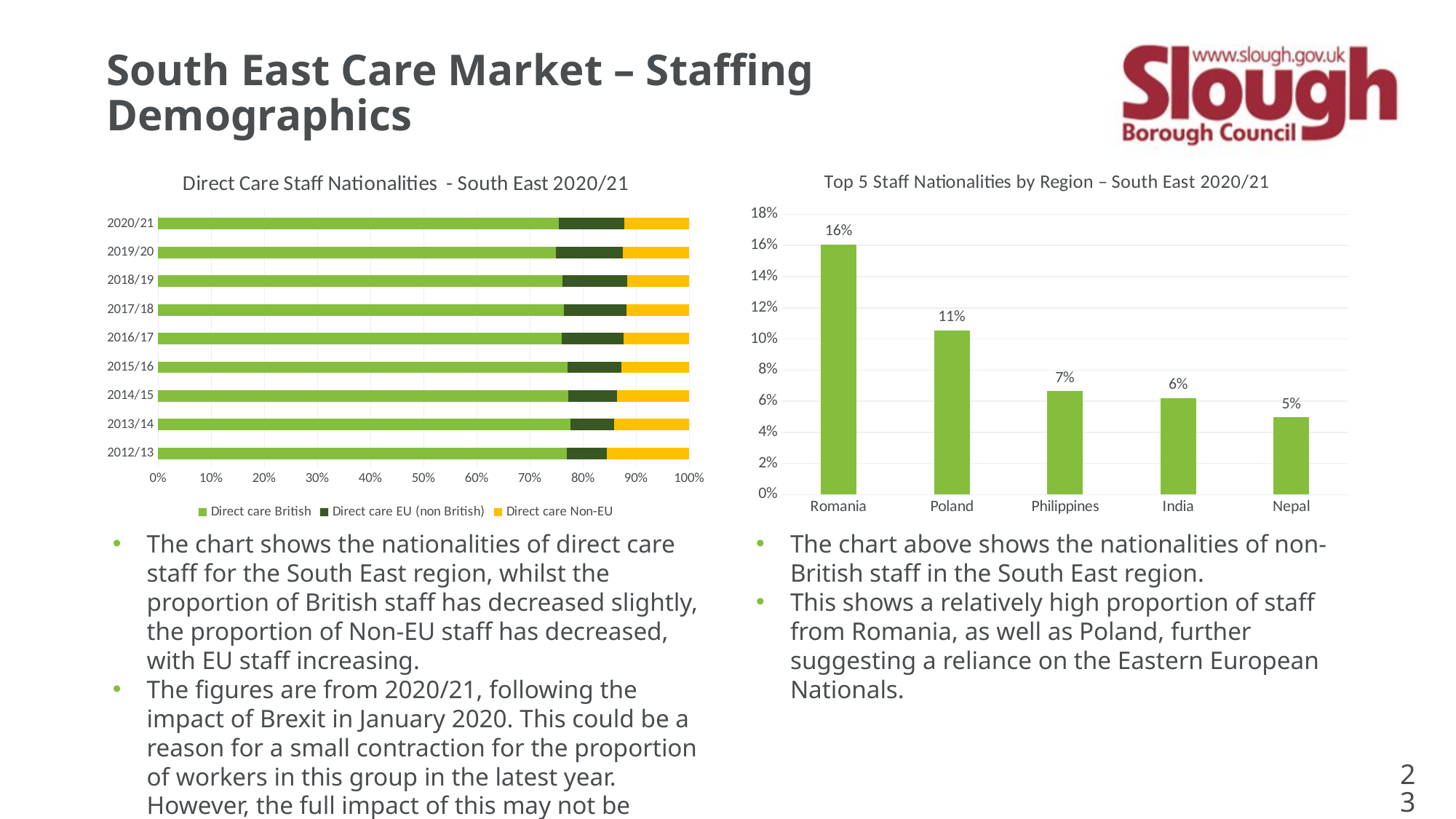
In the 'Top 5 Staff Nationalities by Region' chart, what is the value for Poland? 11% In the 'Direct Care Staff Nationalities - South East 2020/21' chart, is the Direct care British share for 2020/21 greater or less than 70%? greater How many nationalities are shown in the 'Top 5 Staff Nationalities by Region' chart? 5 In the 'Top 5 Staff Nationalities by Region' chart, do the values rise or fall from Romania to Nepal along the x axis? fall In the 'Top 5 Staff Nationalities by Region' chart, which is larger, the value for Philippines or the value for India? Philippines In the 'Top 5 Staff Nationalities by Region' chart, what is the difference between the values for Romania and Poland? 5% In the 'Top 5 Staff Nationalities by Region' chart, which nationality has the lowest value? Nepal In the 'Top 5 Staff Nationalities by Region' chart, what is the value for Romania? 16% How many years are shown in the 'Direct Care Staff Nationalities - South East 2020/21' chart? 9 In the 'Top 5 Staff Nationalities by Region' chart, which nationality has the highest value? Romania How many series does the legend of the 'Direct Care Staff Nationalities - South East 2020/21' chart list? 3 In the 'Top 5 Staff Nationalities by Region' chart, what is the value for Nepal? 5%